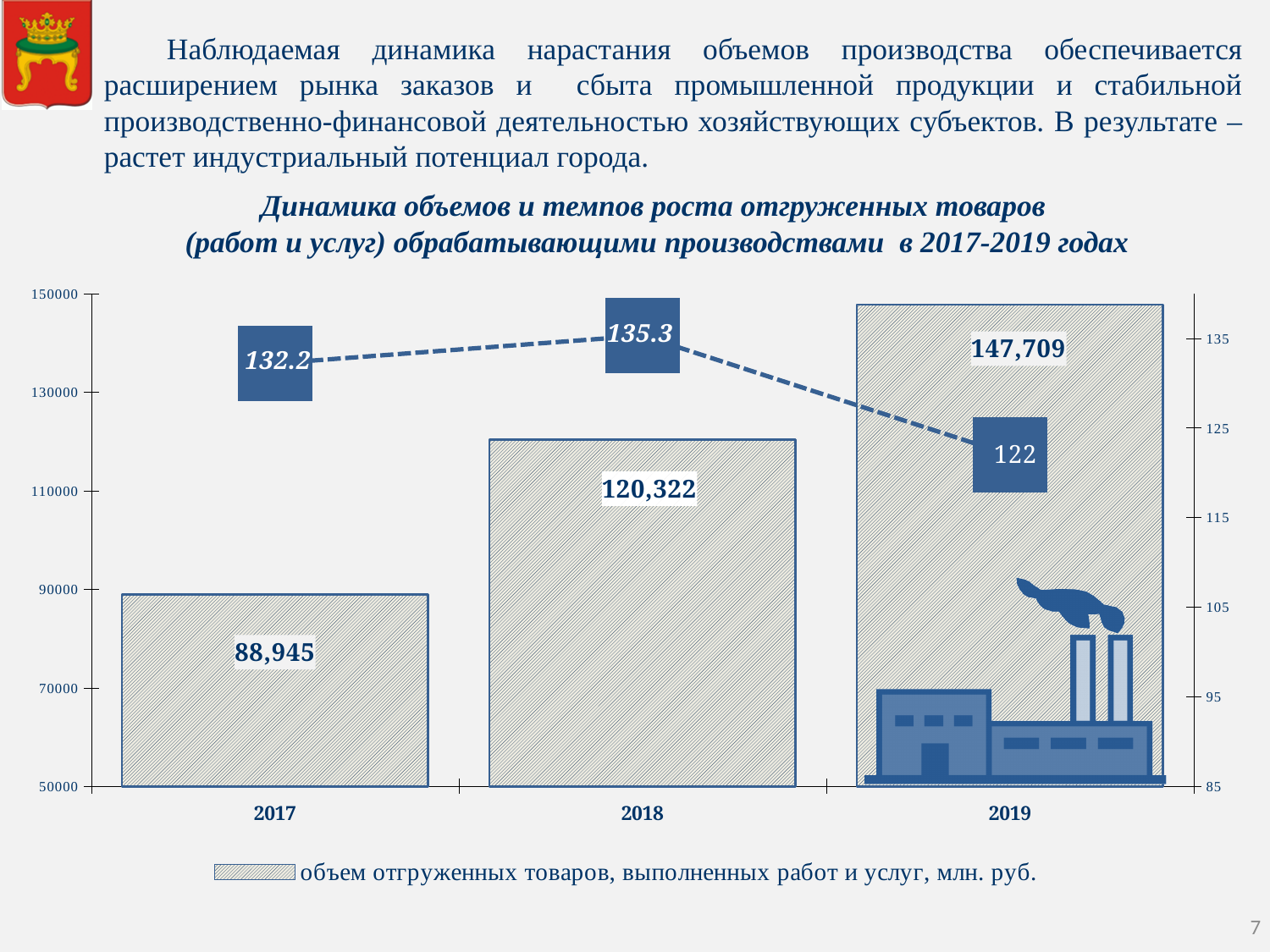
Which is larger: the growth-rate value for 2017 or for 2018? 2018 What is the volume of shipped goods, works and services (million rubles) for 2017? 88,945 What is the difference between the growth-rate values for 2018 and 2019? 13.3 Which year has the highest volume of shipped goods, works and services? 2019 By how much did the volume of shipped goods increase from 2017 to 2018? 31,377 In which year is the growth-rate line at its lowest value? 2019 What value does the dashed growth-rate line show for 2019? 122 What is the volume of shipped goods, works and services (million rubles) for 2018? 120,322 How many years are shown on the x axis of the chart? 3 Do the bar values rise or fall from 2017 to 2019? rise Is the volume of shipped goods for 2019 greater or less than 130000? greater How many series does the legend below the chart list? 1